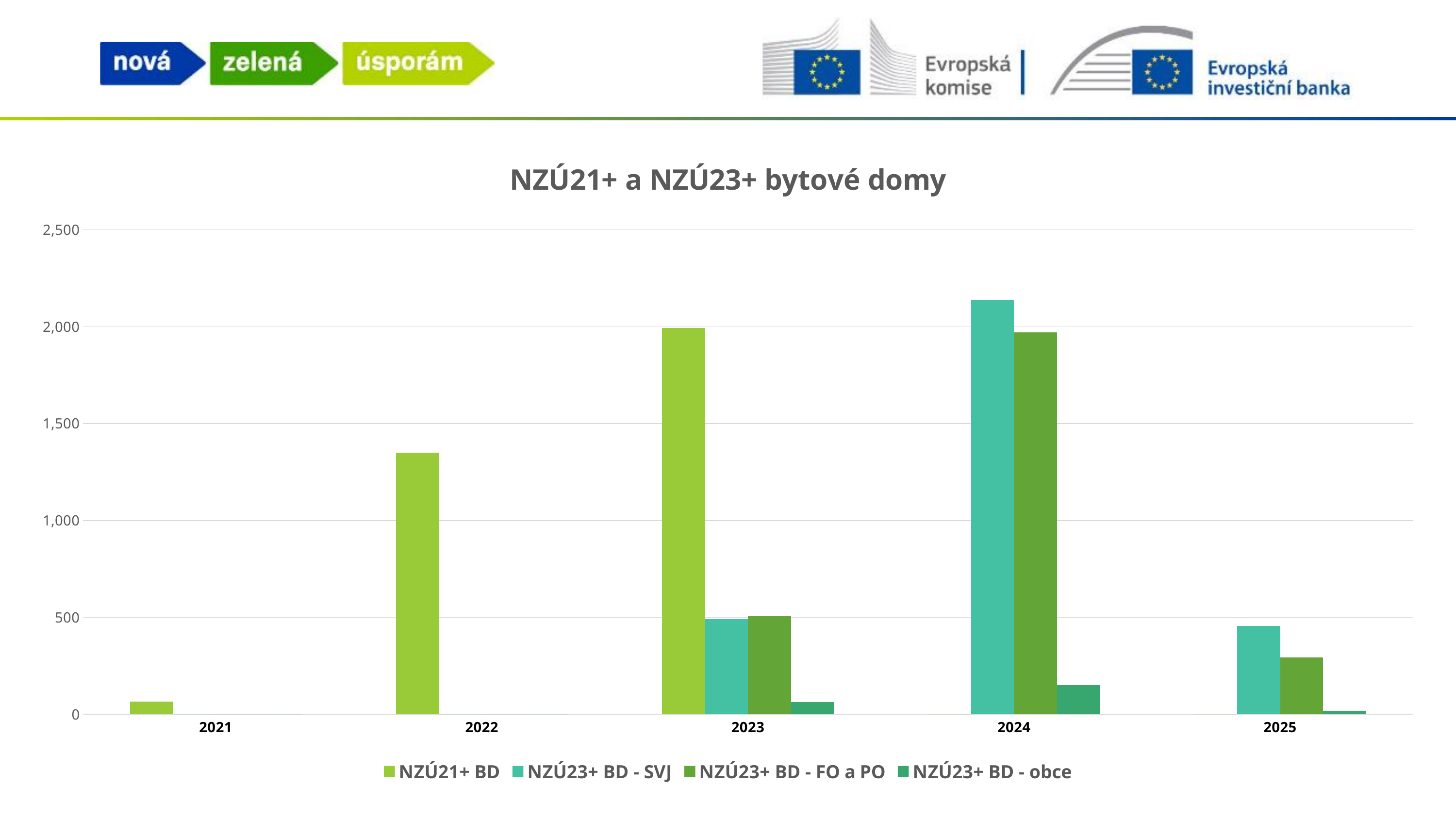
How many years are shown on the x axis? 5 How many series does the legend list? 4 In which year is the NZÚ23+ BD - SVJ bar the tallest? 2024 Which series has the lowest bar in 2024? NZÚ23+ BD - obce Is the value for NZÚ23+ BD - FO a PO in 2024 greater or less than 1,500? greater What is the title of the chart? NZÚ21+ a NZÚ23+ bytové domy In 2024, which is larger: NZÚ23+ BD - SVJ or NZÚ23+ BD - FO a PO? NZÚ23+ BD - SVJ What kind of chart is shown on the slide? bar chart In which year is the NZÚ21+ BD bar the tallest? 2023 Is the value for NZÚ21+ BD in 2022 greater or less than 1,000? greater Is the value for NZÚ23+ BD - SVJ in 2024 greater or less than 2,000? greater